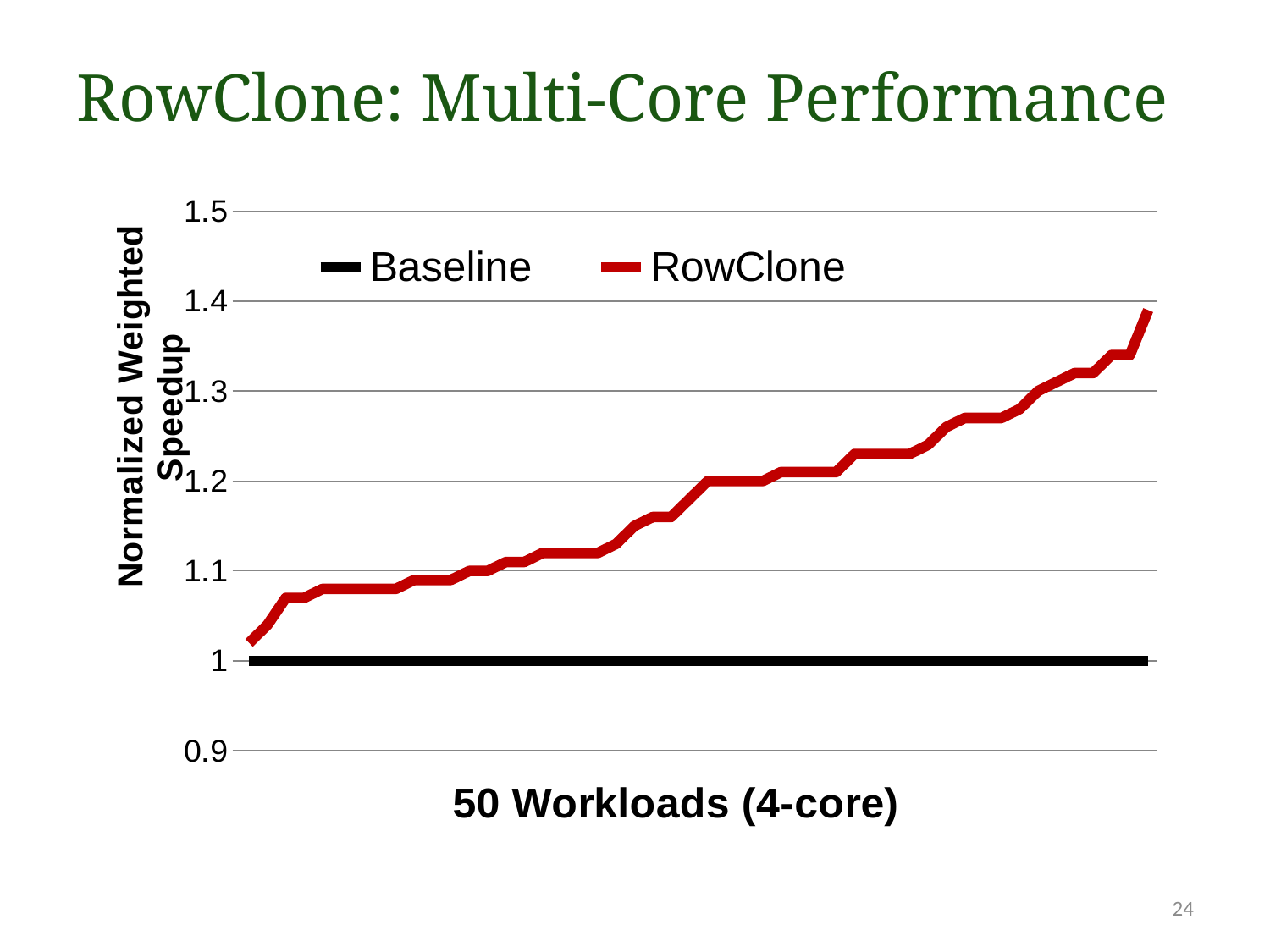
What is the constant value of the Baseline series? 1 What kind of chart is shown on the slide? line chart Which series has higher values across the workloads, Baseline or RowClone? RowClone What is the label on the x axis of the chart? 50 Workloads (4-core) Does the RowClone series rise or fall from left to right along the x axis? rise How many series does the legend list? 2 Is the highest RowClone value greater or less than 1.3? greater How many workloads are plotted along the x axis according to the axis label? 50 What are the two series named in the legend? Baseline and RowClone Is the lowest RowClone value greater or less than 1.1? less What is the title of the slide containing the chart? RowClone: Multi-Core Performance